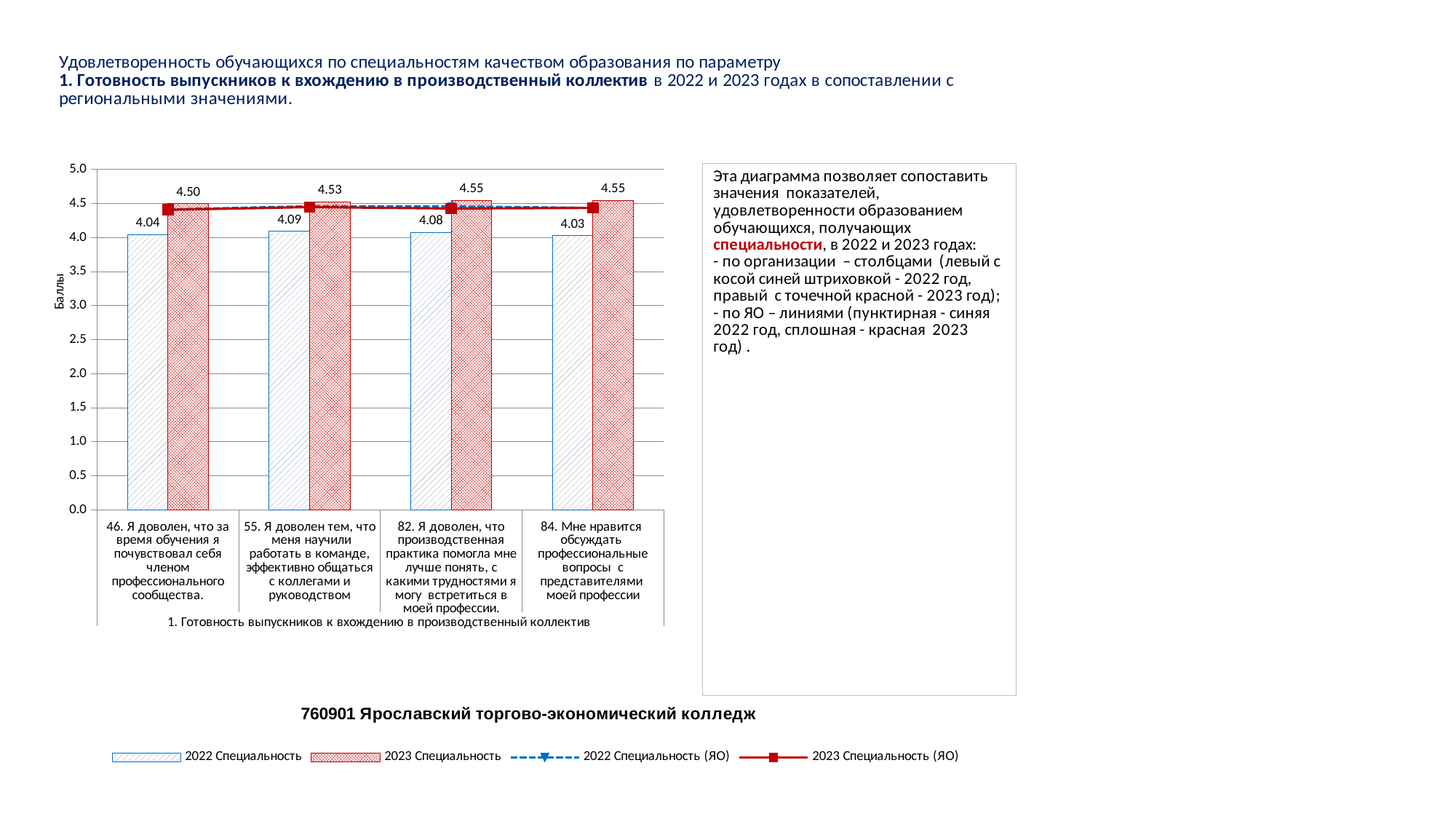
What is the value of the 2023 Специальность bar for item 46 (Я доволен, что за время обучения я почувствовал себя членом профессионального сообщества)? 4.50 What is the value of the 2022 Специальность bar for item 84 (Мне нравится обсуждать профессиональные вопросы)? 4.03 For item 82, which is larger: the 2022 Специальность bar or the 2023 Специальность bar? 2023 Специальность Which item has the highest 2022 Специальность value? 55. Я доволен тем, что меня научили работать в команде, эффективно общаться с коллегами и руководством What is the value of the 2022 Специальность bar for item 55 (Я доволен тем, что меня научили работать в команде)? 4.09 How many categories (items) are shown on the x axis? 4 What is the difference between the 2023 and 2022 Специальность values for item 46? 0.46 What is the label of the vertical axis? Баллы Is the 2022 Специальность (ЯО) line value for item 46 greater or less than 4.0? greater How many series does the legend list? 4 What is the difference between the 2023 and 2022 Специальность values for item 84? 0.52 Which item has the lowest 2022 Специальность value? 84. Мне нравится обсуждать профессиональные вопросы с представителями моей профессии